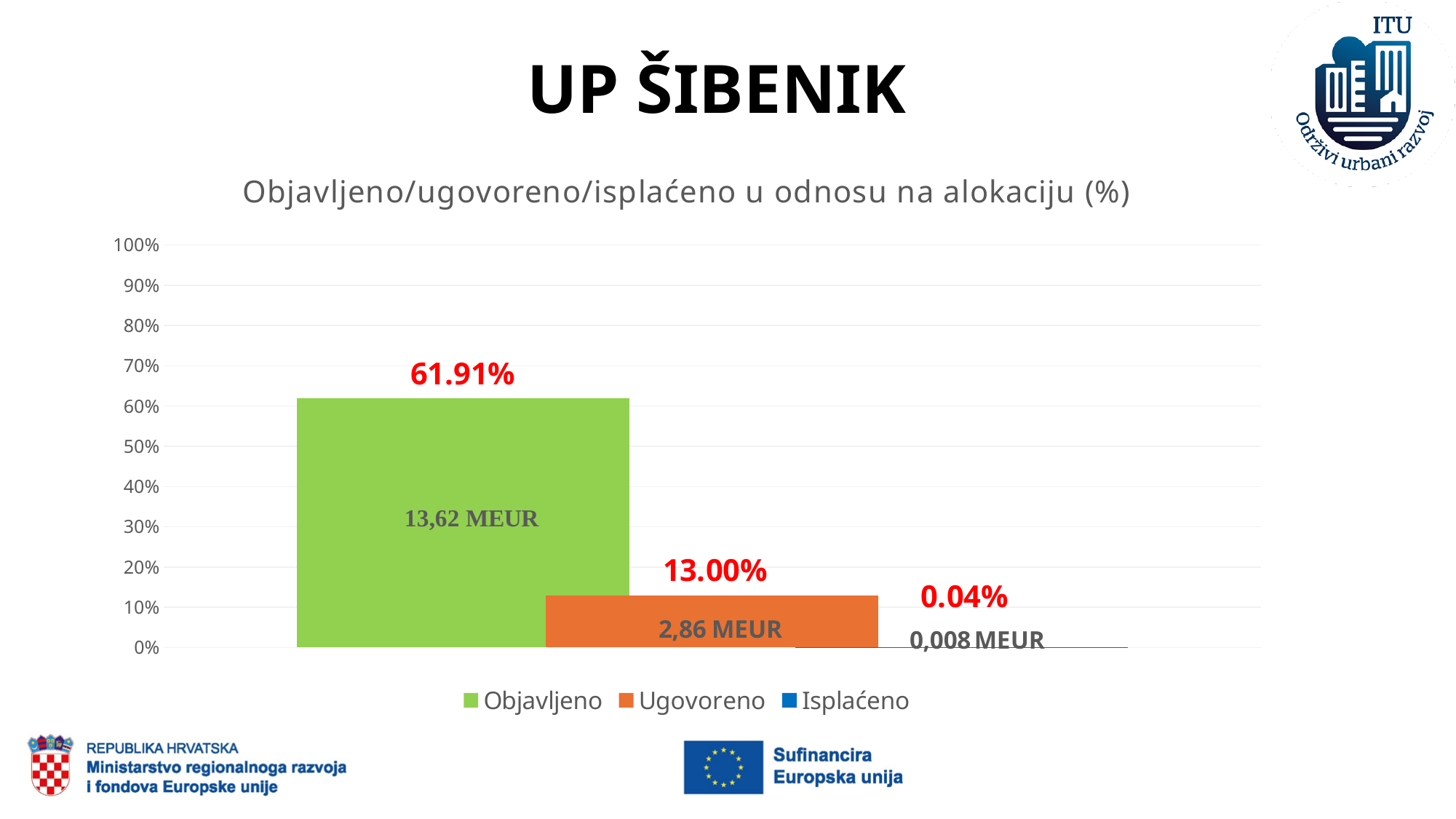
What is the difference between the Objavljeno and Ugovoreno percentages? 48.91% Which series has the lowest value? Isplaćeno What is the value for Ugovoreno? 13.00% What is the value for Isplaćeno? 0.04% Which series has the highest value? Objavljeno Which is larger, Ugovoreno or Isplaćeno? Ugovoreno What amount in MEUR is shown for Ugovoreno? 2,86 MEUR Is the value for Objavljeno greater or less than 60%? greater How many series does the legend list? 3 What is the value for Objavljeno? 61.91% What kind of chart is shown? Bar chart What amount in MEUR is shown for Objavljeno? 13,62 MEUR